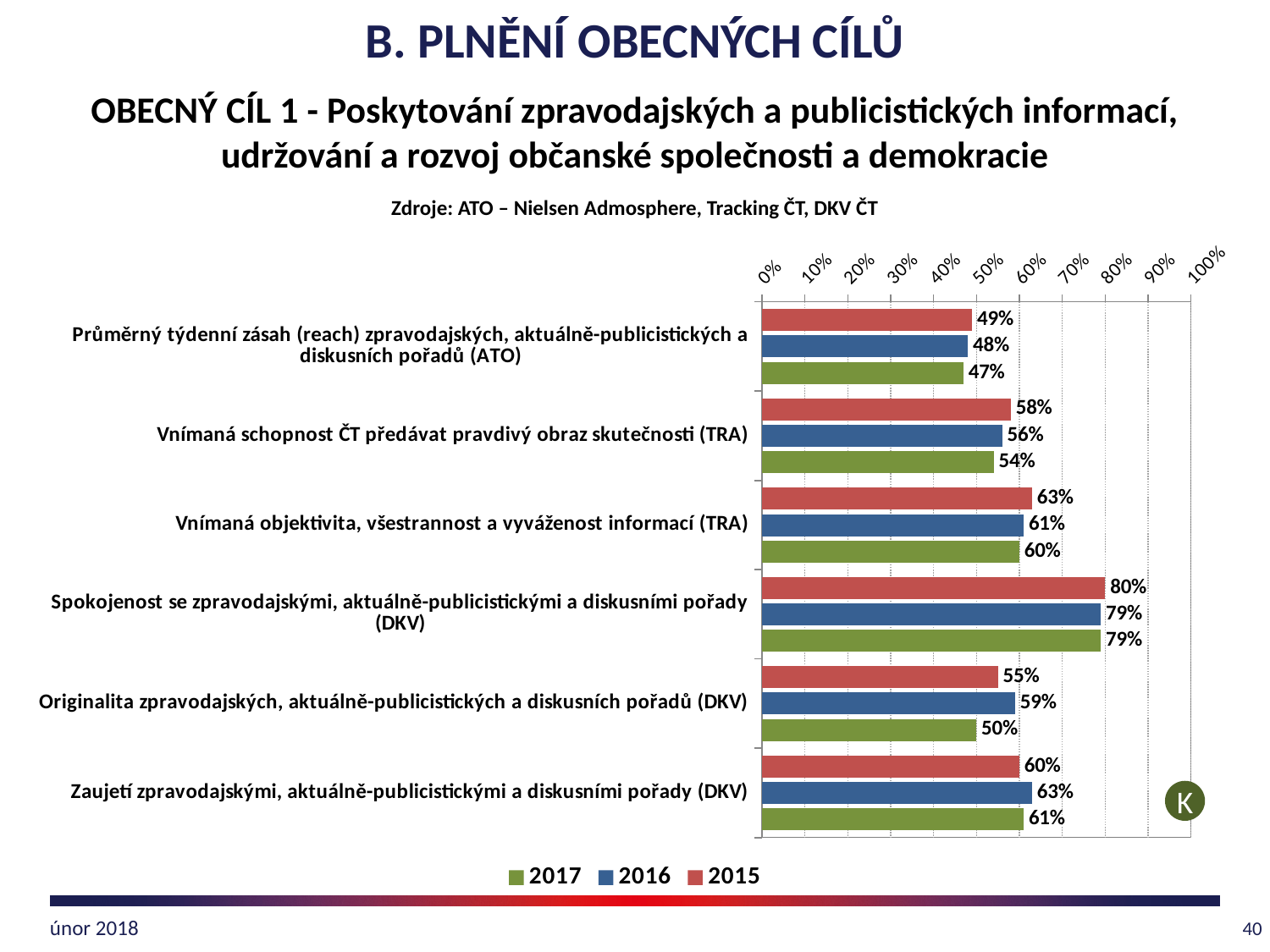
What is the 2017 value for "Průměrný týdenní zásah (reach) zpravodajských, aktuálně-publicistických a diskusních pořadů (ATO)"? 47% What kind of chart is shown on the slide? Bar chart Which category has the highest 2017 value? Spokojenost se zpravodajskými, aktuálně-publicistickými a diskusními pořady (DKV) Is the 2015 value for "Spokojenost se zpravodajskými, aktuálně-publicistickými a diskusními pořady (DKV)" greater or less than 70%? greater For "Zaujetí zpravodajskými, aktuálně-publicistickými a diskusními pořady (DKV)", which year has the larger value, 2015 or 2016? 2016 What is the 2015 value for "Vnímaná schopnost ČT předávat pravdivý obraz skutečnosti (TRA)"? 58% How many series does the legend list? 3 Which category has the lowest 2015 value? Průměrný týdenní zásah (reach) zpravodajských, aktuálně-publicistických a diskusních pořadů (ATO) What is the difference between the 2016 and 2017 values for "Originalita zpravodajských, aktuálně-publicistických a diskusních pořadů (DKV)"? 9% What is the 2016 value for "Originalita zpravodajských, aktuálně-publicistických a diskusních pořadů (DKV)"? 59% How many categories are shown on the chart? 6 Which colour represents the 2016 series in the legend? Blue